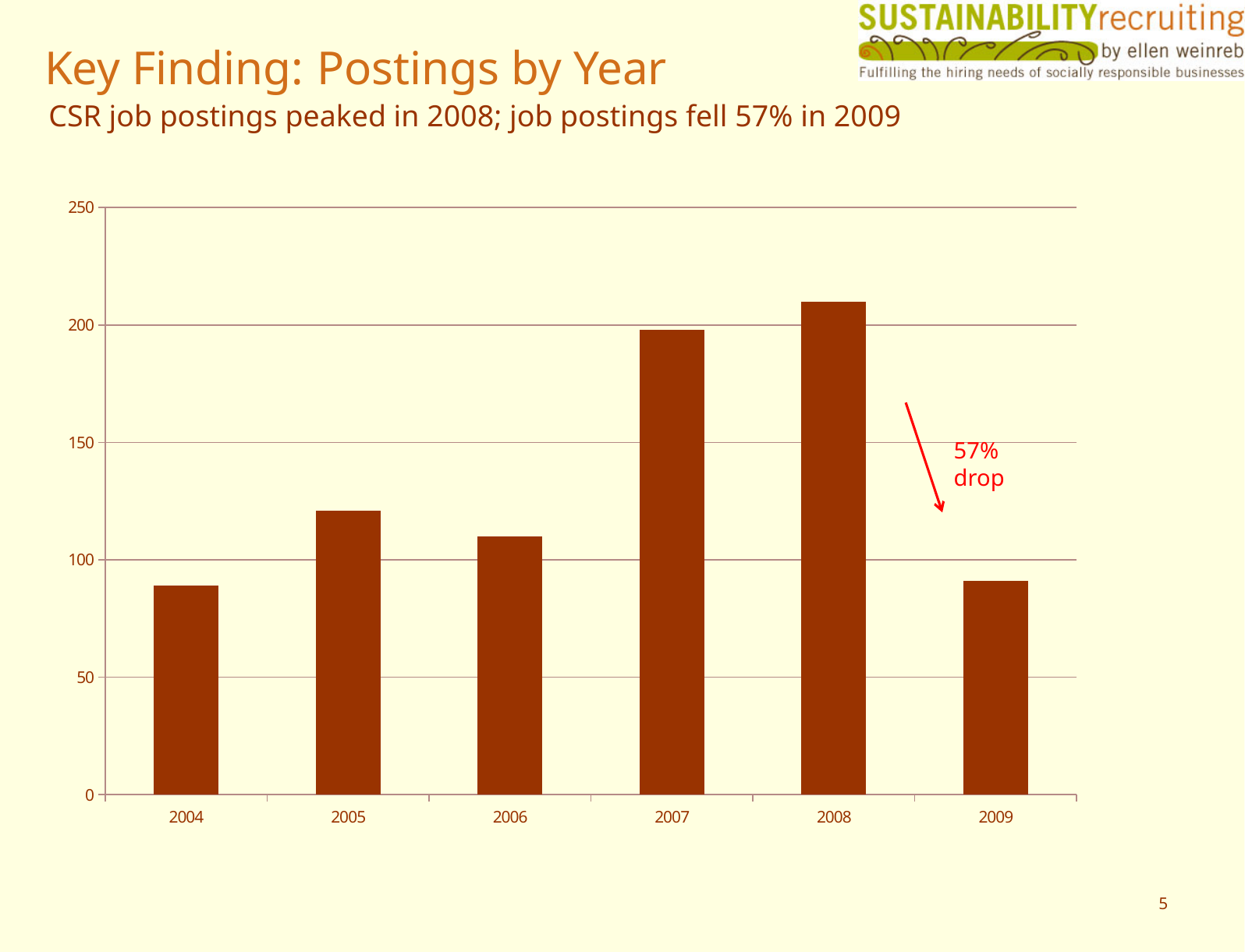
Is the value for 2008 greater or less than 200? greater What kind of chart is shown on the slide? bar chart Is the value for 2005 greater or less than 100? greater What percentage drop does the red annotation on the chart indicate? 57% drop Which year has more postings, 2007 or 2008? 2008 Which year has more postings, 2005 or 2006? 2005 Is the value for 2009 greater or less than 100? less How many years are shown on the x axis of the chart? 6 Do postings rise or fall from 2008 to 2009? fall Which year has the highest number of postings? 2008